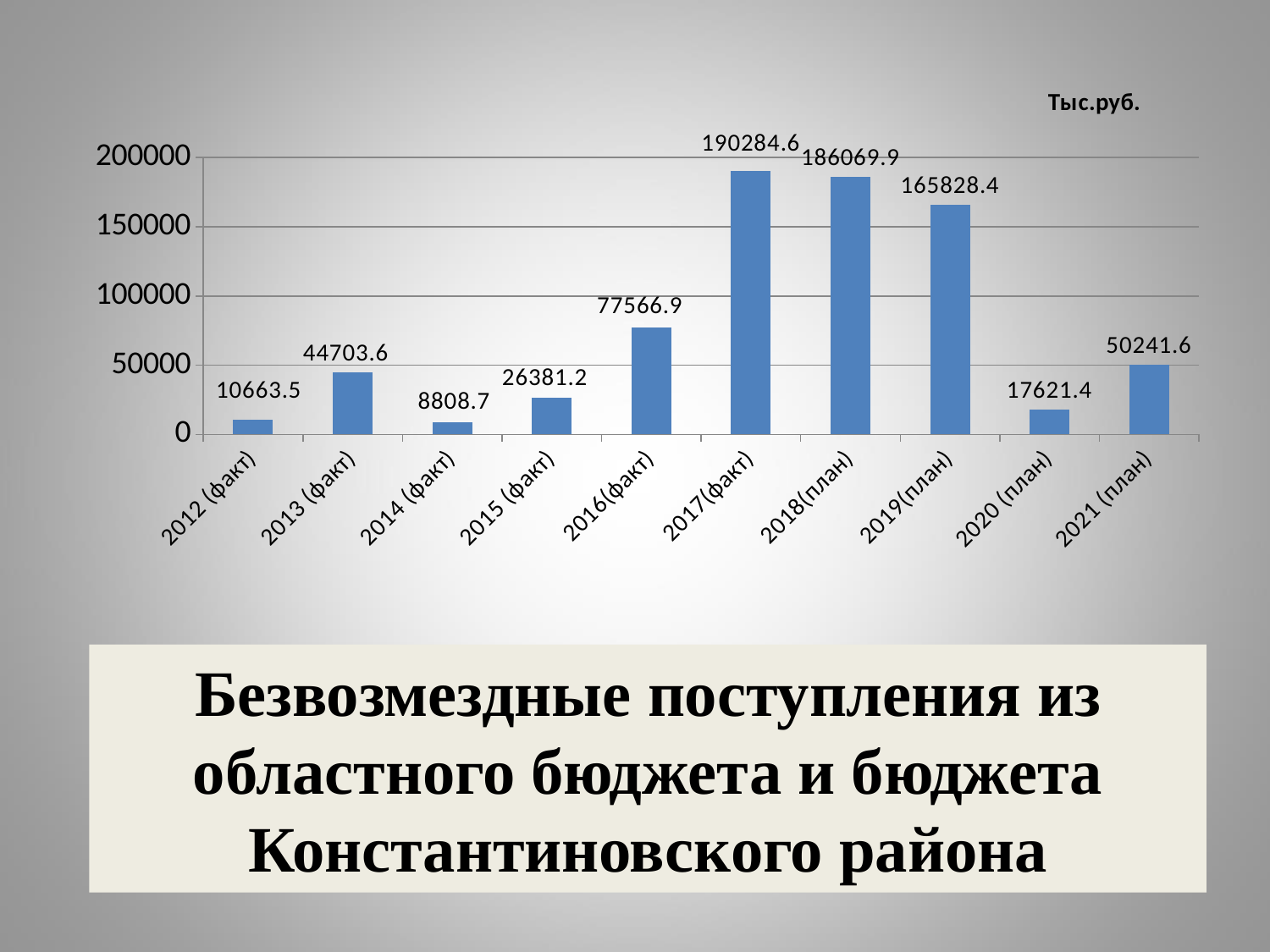
What is the value for 2021 (план)? 50241.6 Do the values rise or fall from 2012 (факт) to 2017(факт)? rise What is the value for 2017(факт)? 190284.6 How many categories are shown on the x axis? 10 Which category has the lowest value? 2014 (факт) What kind of chart is shown on the slide? bar chart Which is larger, the value for 2013 (факт) or the value for 2021 (план)? 2021 (план) Which category has the highest value? 2017(факт) Is the value for 2019(план) greater or less than 150000? greater What is the value for 2014 (факт)? 8808.7 What is the difference between the values for 2017(факт) and 2018(план)? 4214.7 What unit is indicated in the top right corner of the chart? Тыс.руб.